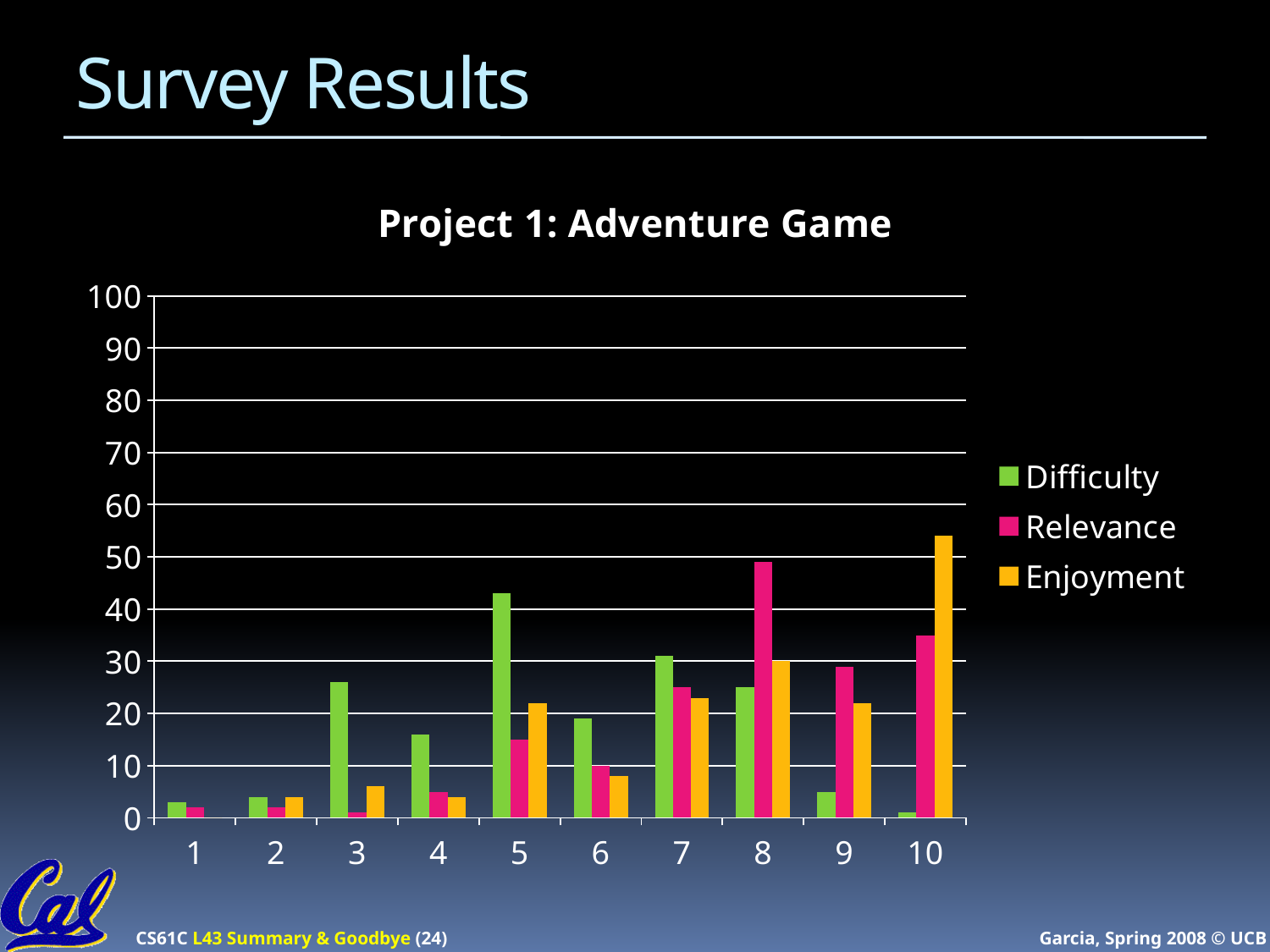
Is the Enjoyment value at category 10 greater or less than 50? greater How many categories are shown on the x axis? 10 Which series is shown in green in the legend? Difficulty At which x-axis category is the Enjoyment bar highest? 10 At which x-axis category is the Relevance bar highest? 8 Is the Relevance value at category 8 greater or less than 40? greater Is the Difficulty value at category 1 greater or less than 10? less What kind of chart is shown on the slide? bar chart How many series does the legend list? 3 At which x-axis category is the Difficulty bar highest? 5 What is the title of the chart? Project 1: Adventure Game At category 8, which is larger, Difficulty or Relevance? Relevance